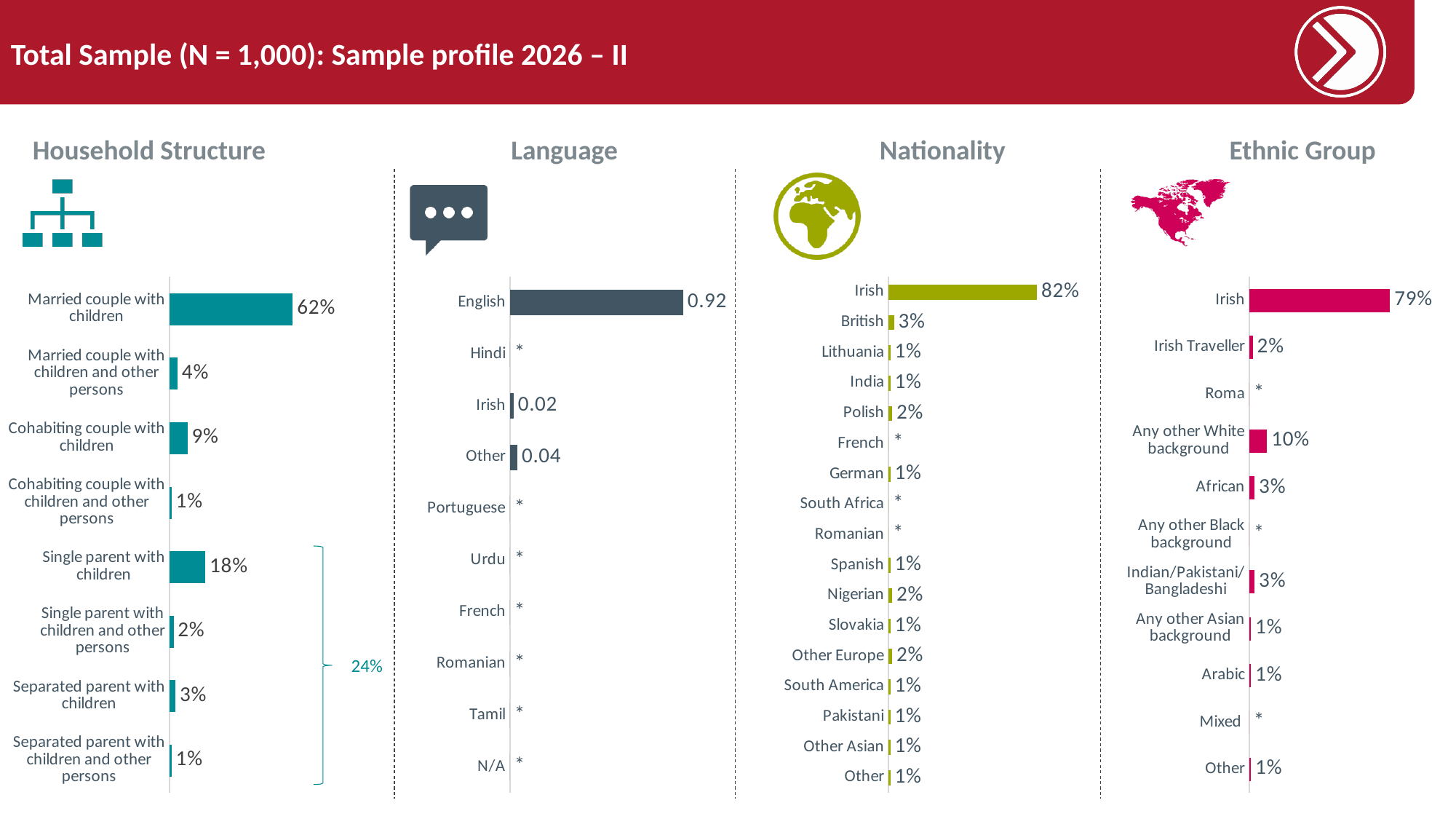
In the Household Structure chart, what is the value for Single parent with children? 18% In the Ethnic Group chart, what is the value for Any other White background? 10% In the Household Structure chart, what is the difference between Married couple with children and Single parent with children? 44% In the Nationality chart, what is the value for Irish? 82% In the Ethnic Group chart, what is the difference between Irish and Any other White background? 69% In the Nationality chart, which is larger, British or Polish? British How many categories are shown in the Ethnic Group chart? 11 What kind of chart is the Nationality chart? Bar chart In the Language chart, what is the value for Other? 0.04 In the Language chart, what is the value for English? 0.92 In the Household Structure chart, which category has the highest value? Married couple with children In the Household Structure chart, what is the value for Married couple with children? 62%